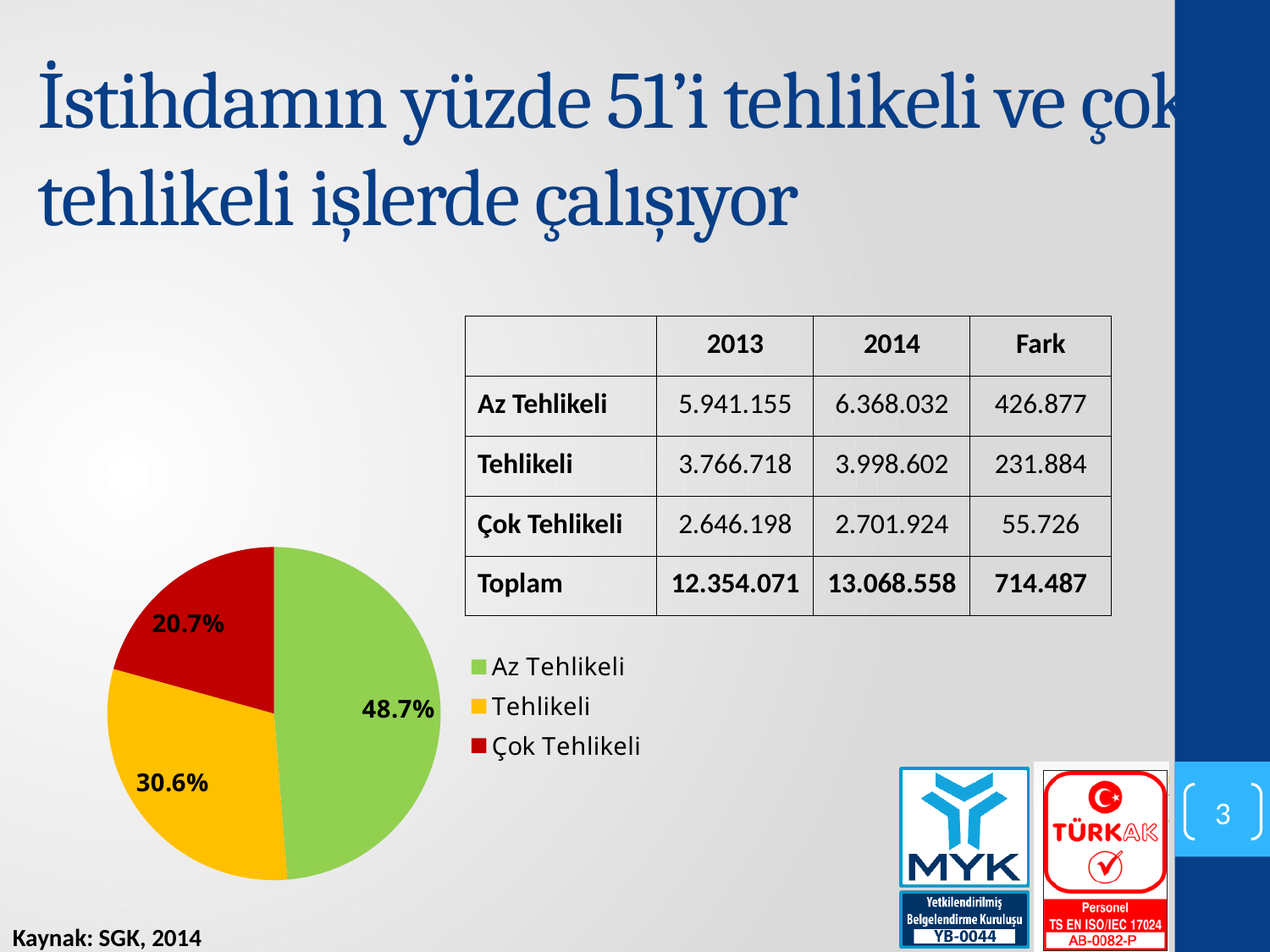
What share of the pie chart does Az Tehlikeli represent? 48.7% What kind of chart is shown on the slide? Pie chart What share of the pie chart does Tehlikeli represent? 30.6% What share of the pie chart does Çok Tehlikeli represent? 20.7% Which slice is larger, Tehlikeli or Çok Tehlikeli? Tehlikeli What is the difference in percentage points between the Az Tehlikeli and Çok Tehlikeli slices? 28.0% Which category has the smallest slice in the pie chart? Çok Tehlikeli How many slices does the pie chart have? 3 What colour is the Çok Tehlikeli slice in the pie chart? Red Which category does the green slice of the pie chart represent? Az Tehlikeli What is the difference in percentage points between the Tehlikeli and Çok Tehlikeli slices? 9.9% Which category has the largest slice in the pie chart? Az Tehlikeli